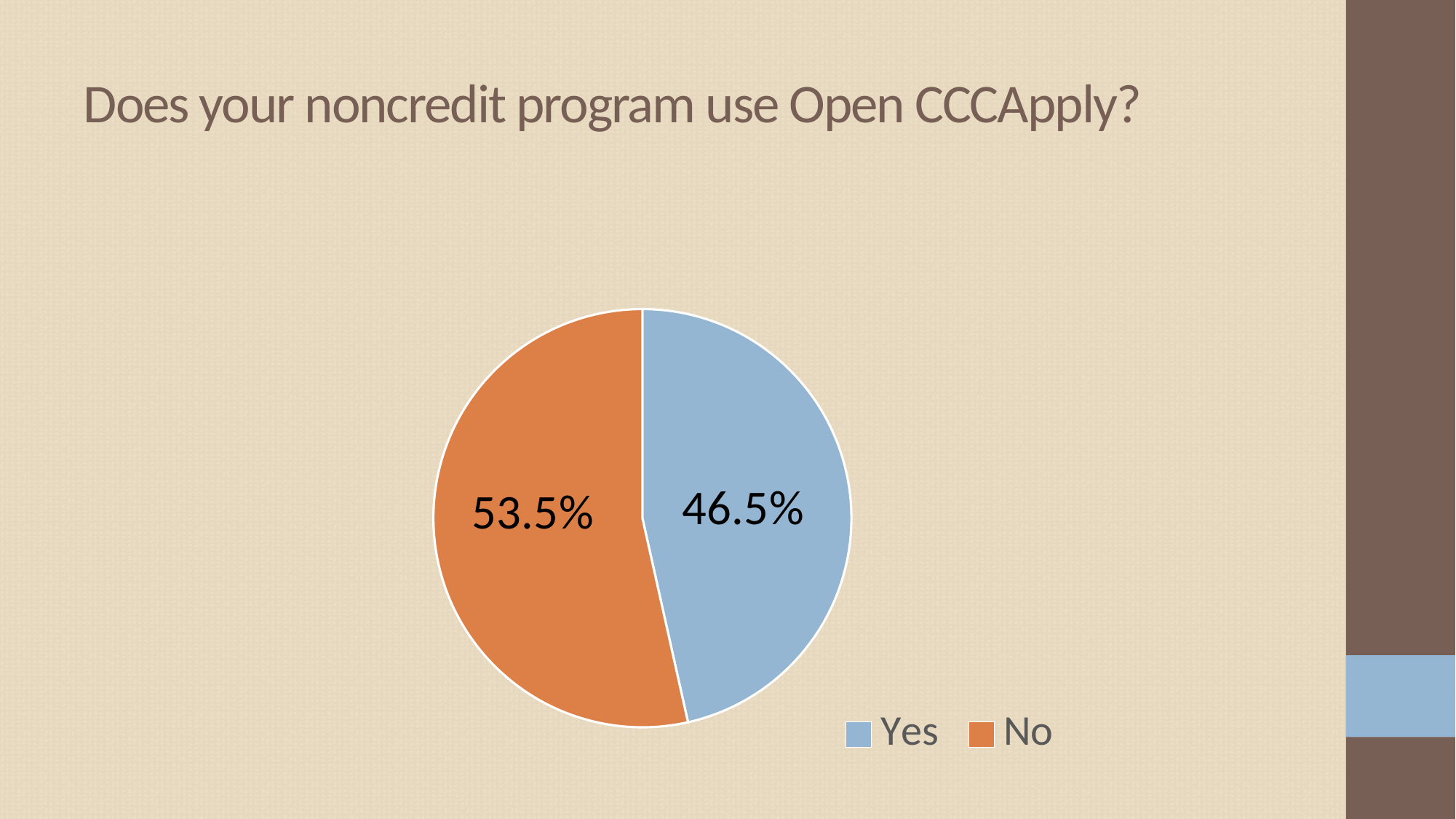
Is the Yes slice larger or smaller than the No slice? smaller What percentage of respondents answered Yes? 46.5% How many entries does the legend list? 2 What percentage of respondents answered No? 53.5% What kind of chart is shown on the slide? pie chart What question does the chart title ask? Does your noncredit program use Open CCCApply? Which response has the larger share of the pie? No Which response has the smaller share of the pie? Yes What is the difference in percentage points between the No and Yes slices? 7 percentage points How many slices does the pie chart have? 2 Which colour represents the Yes response in the pie chart? blue What share of the pie does the No slice represent? 53.5%